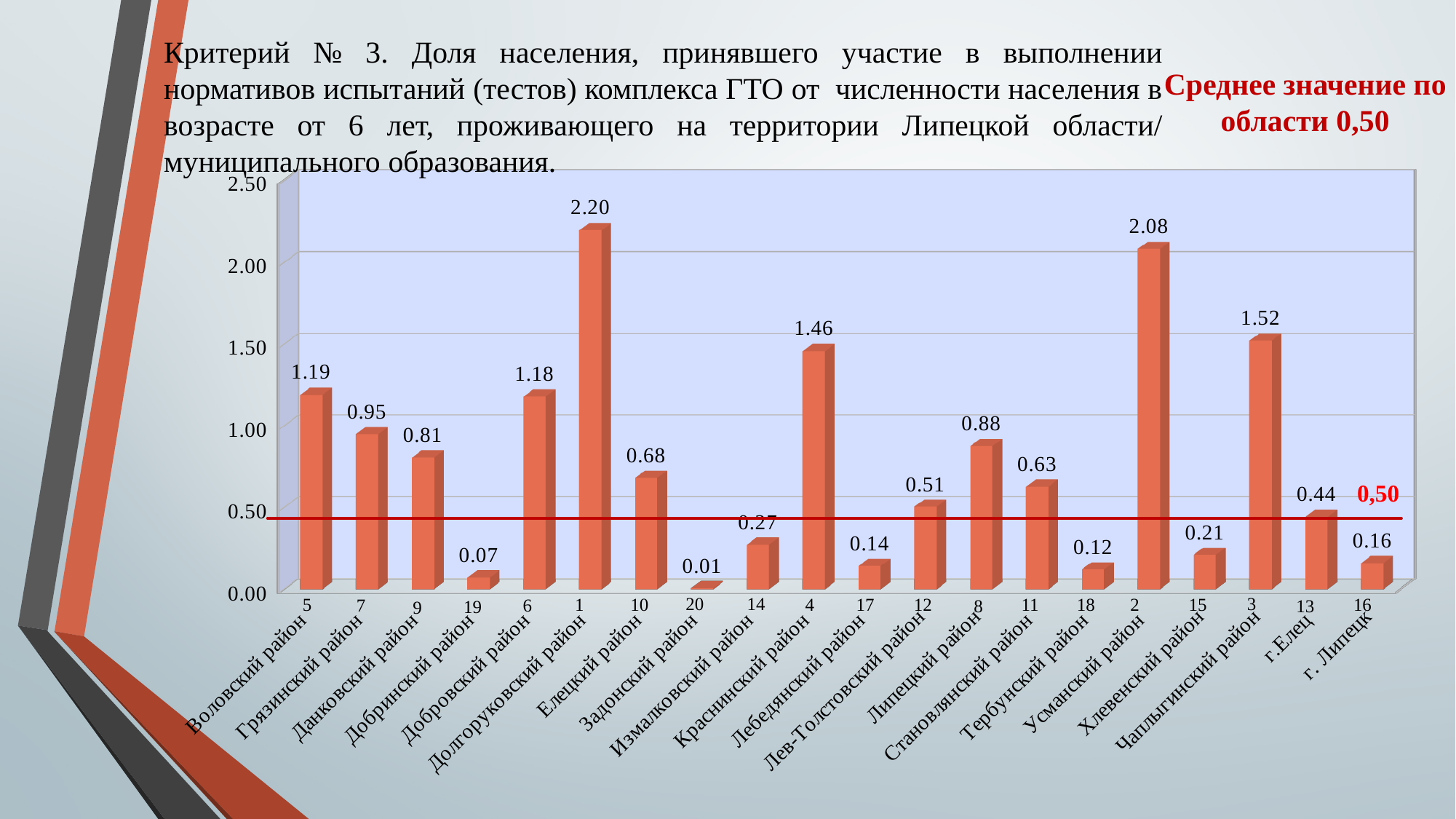
How many districts are shown on the x axis? 20 What is the value for Краснинский район? 1.46 What is the value for г. Липецк? 0.16 Which district has the highest value? Долгоруковский район What kind of chart is shown on the slide? bar chart What value does the red horizontal line on the chart mark? 0,50 What is the value for Тербунский район? 0.12 Is the value for Липецкий район greater or less than 0.50? greater Which district has the lowest value? Задонский район What is the value for Долгоруковский район? 2.20 What is the difference between the values for Усманский район and Чаплыгинский район? 0.56 Which is larger, the value for Воловский район or the value for Добровский район? Воловский район